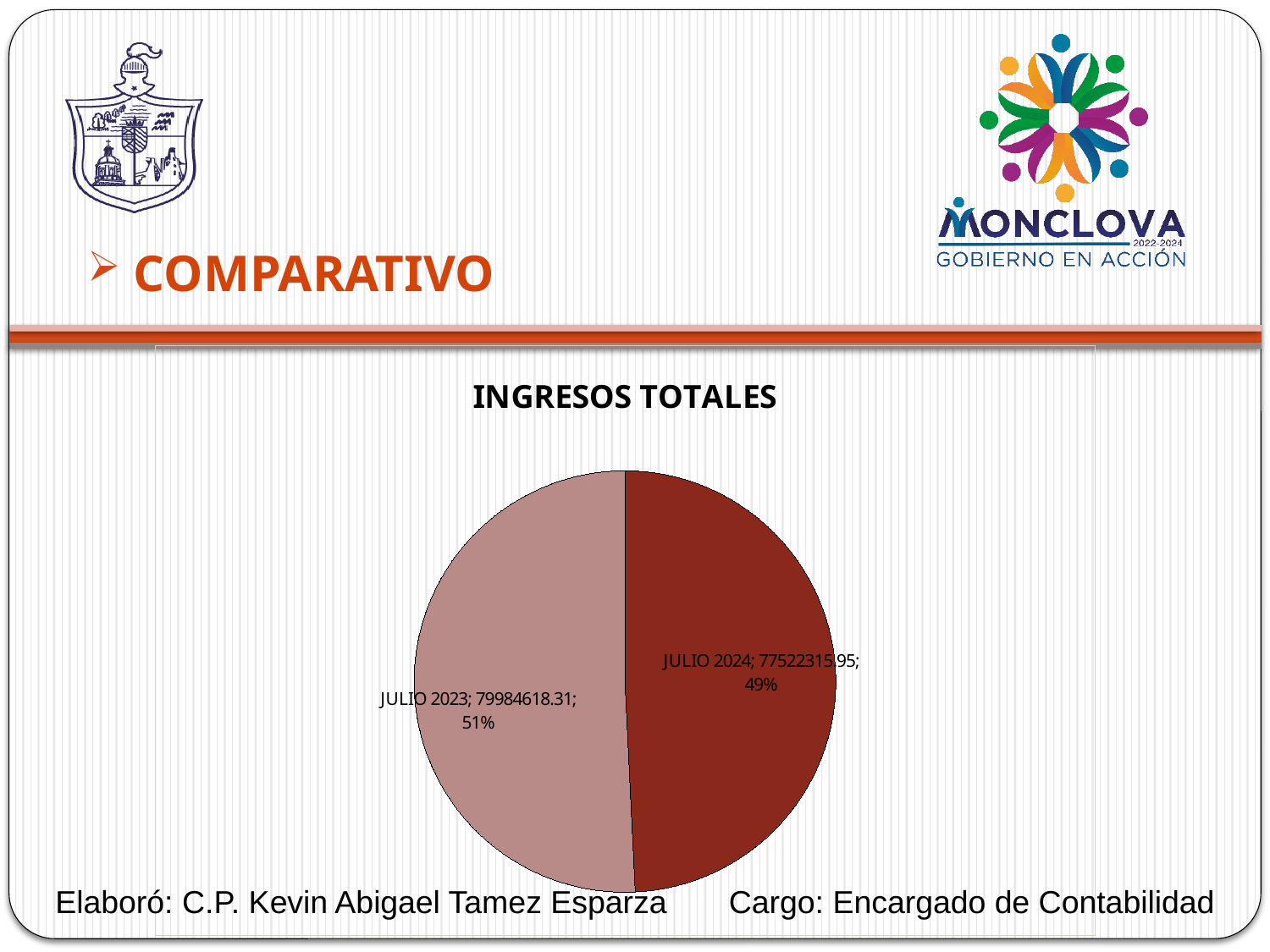
What share of the pie does JULIO 2024 represent? 49% What is the difference between the values for JULIO 2023 and JULIO 2024? 2462302.36 Which is larger, the value for JULIO 2023 or JULIO 2024? JULIO 2023 What is the value for JULIO 2023? 79984618.31 What share of the pie does JULIO 2023 represent? 51% Which slice is the smallest? JULIO 2024 Which slice is the largest? JULIO 2023 What is the total of the two values shown in the pie chart? 157506934.26 What is the title of the chart? INGRESOS TOTALES What kind of chart is shown on the slide? Pie chart How many slices does the pie chart have? 2 What is the value for JULIO 2024? 77522315.95